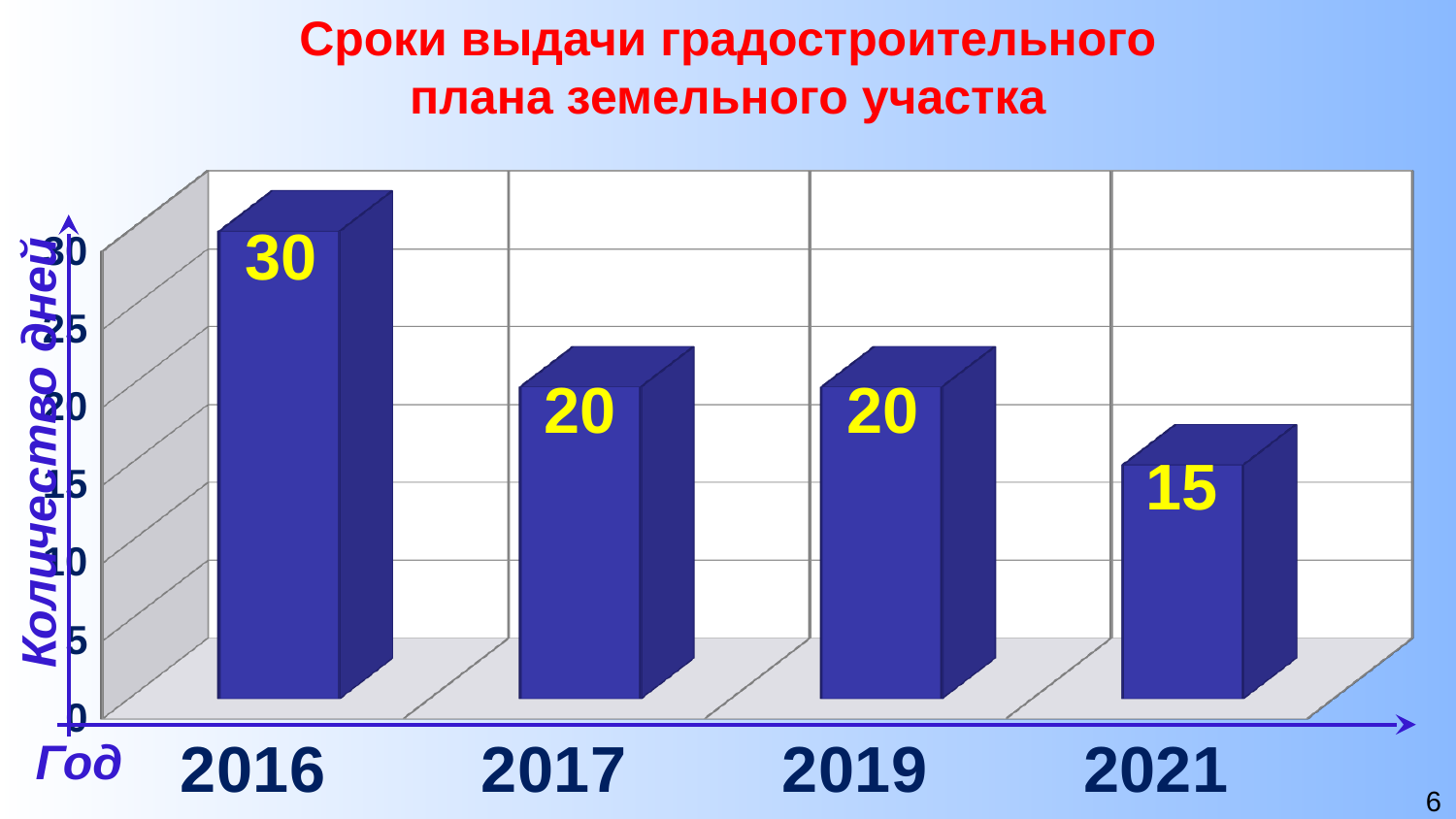
Which year has the highest value? 2016 What is the value for 2017? 20 Which year has the lowest value? 2021 Which is larger, the value for 2016 or the value for 2019? 2016 What is the difference between the values for 2016 and 2021? 15 What is the value for 2021? 15 What kind of chart is shown on the slide? bar chart Is the value for 2021 greater or less than 20? less Do the values rise or fall from 2016 to 2021? fall How many years are shown on the x axis? 4 What is the difference between the values for 2017 and 2021? 5 What is the value for 2016? 30